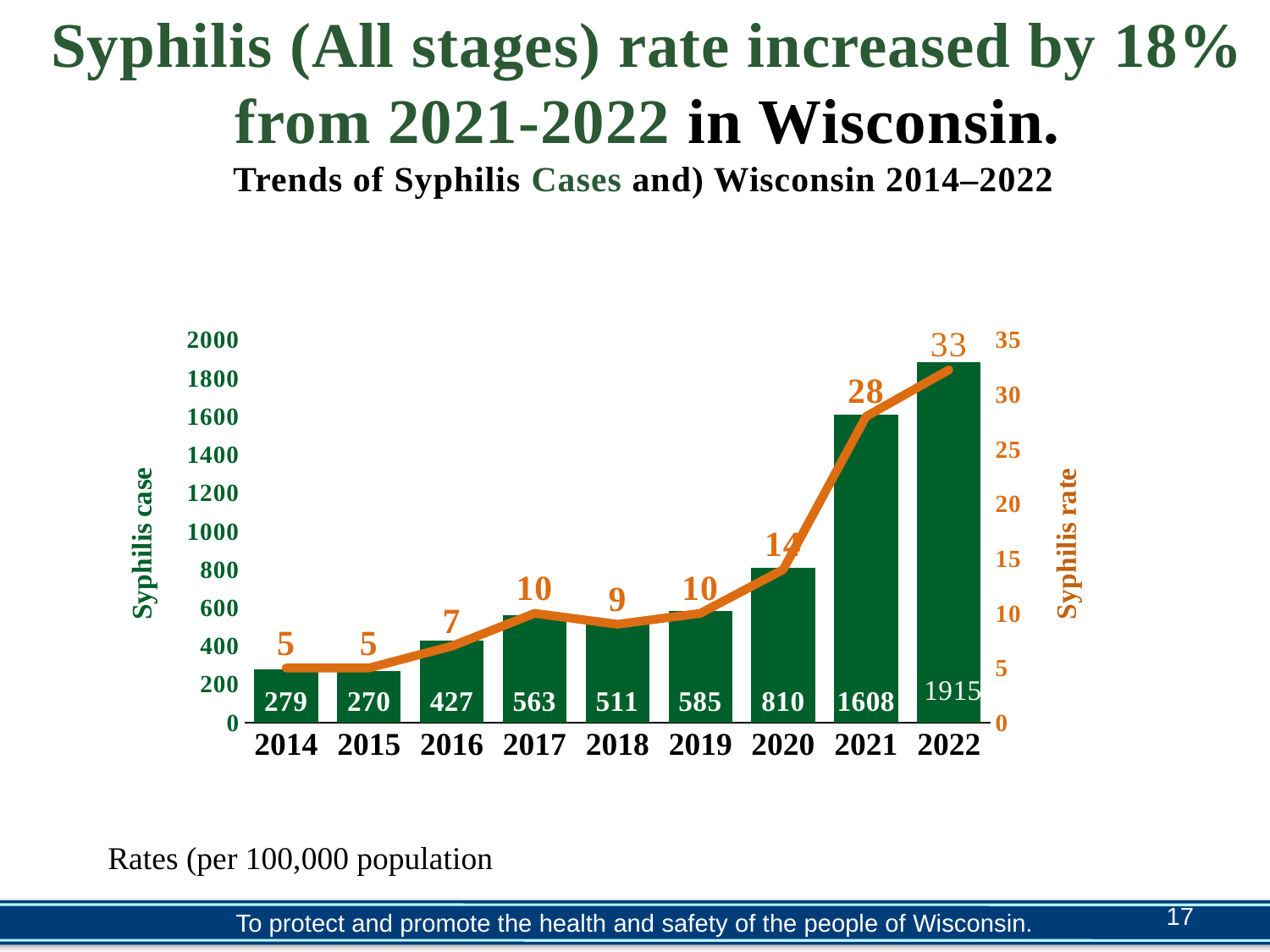
What is the label of the right-hand vertical axis? Syphilis rate What kind of chart is used to show the syphilis cases? Bar chart What is the difference in syphilis rate between 2021 and 2020? 14 How many syphilis cases were reported in 2016? 427 How many years are shown on the x axis of the chart? 9 Which year had more syphilis cases, 2017 or 2018? 2017 Does the syphilis rate generally rise or fall from 2014 to 2022? Rise How many syphilis cases were reported in Wisconsin in 2021? 1608 What was the syphilis rate in 2022? 33 What is the difference in syphilis cases between 2022 and 2021? 307 Which year had the highest number of syphilis cases? 2022 Which year had the lowest number of syphilis cases? 2015